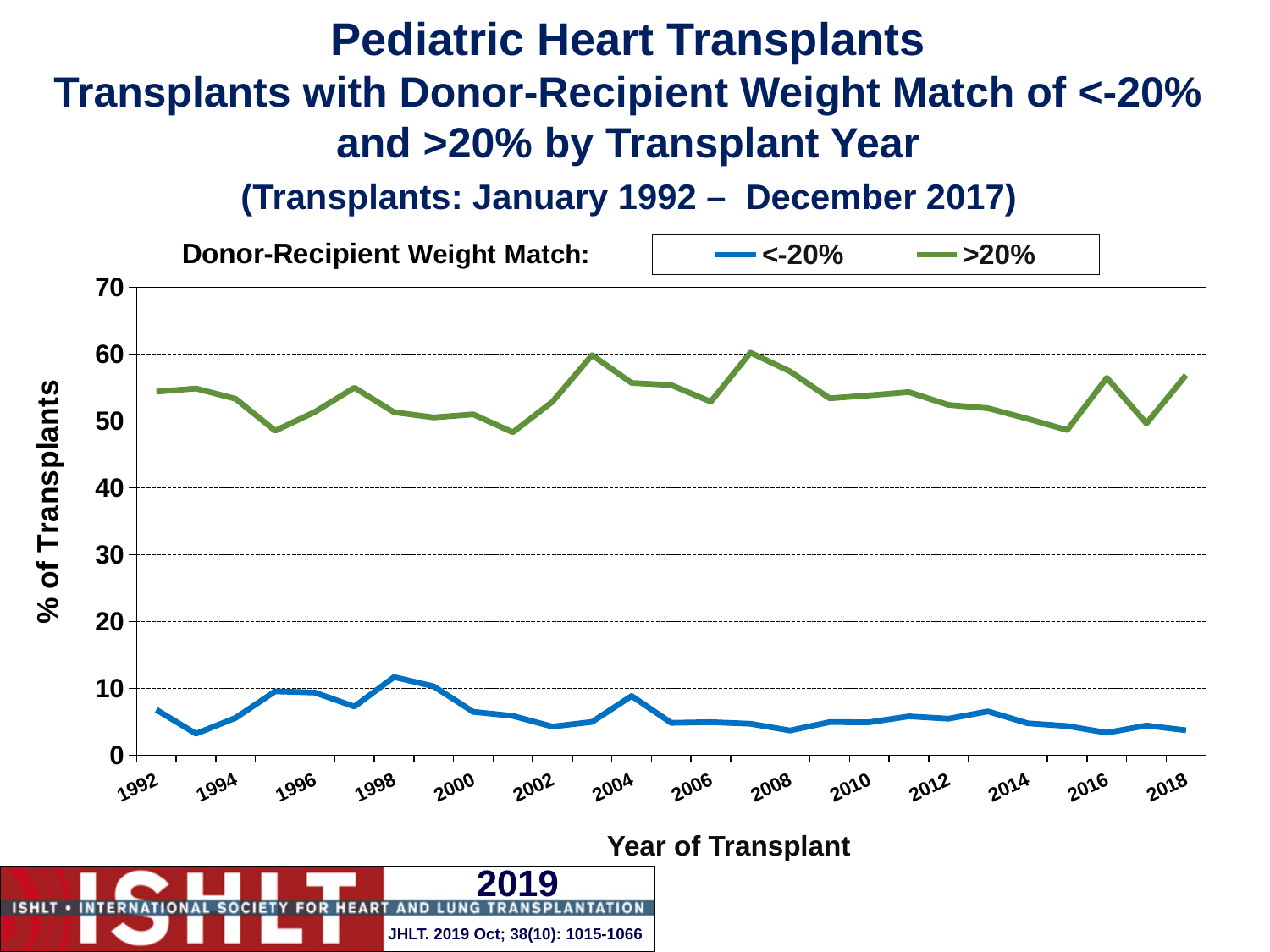
Is the value for the <-20% series in 1998 greater or less than 10? greater What are the two series named in the legend? <-20% and >20% What type of chart is shown on the slide? line chart How many year labels are shown on the x axis? 14 Is the value for the >20% series in 2003 greater or less than 50? greater Is the value for the <-20% series in 1993 greater or less than 10? less How many series does the legend list? 2 What is the label of the y axis? % of Transplants Which series has the higher value in 2010, <-20% or >20%? >20% In which year does the <-20% series reach its highest value? 1998